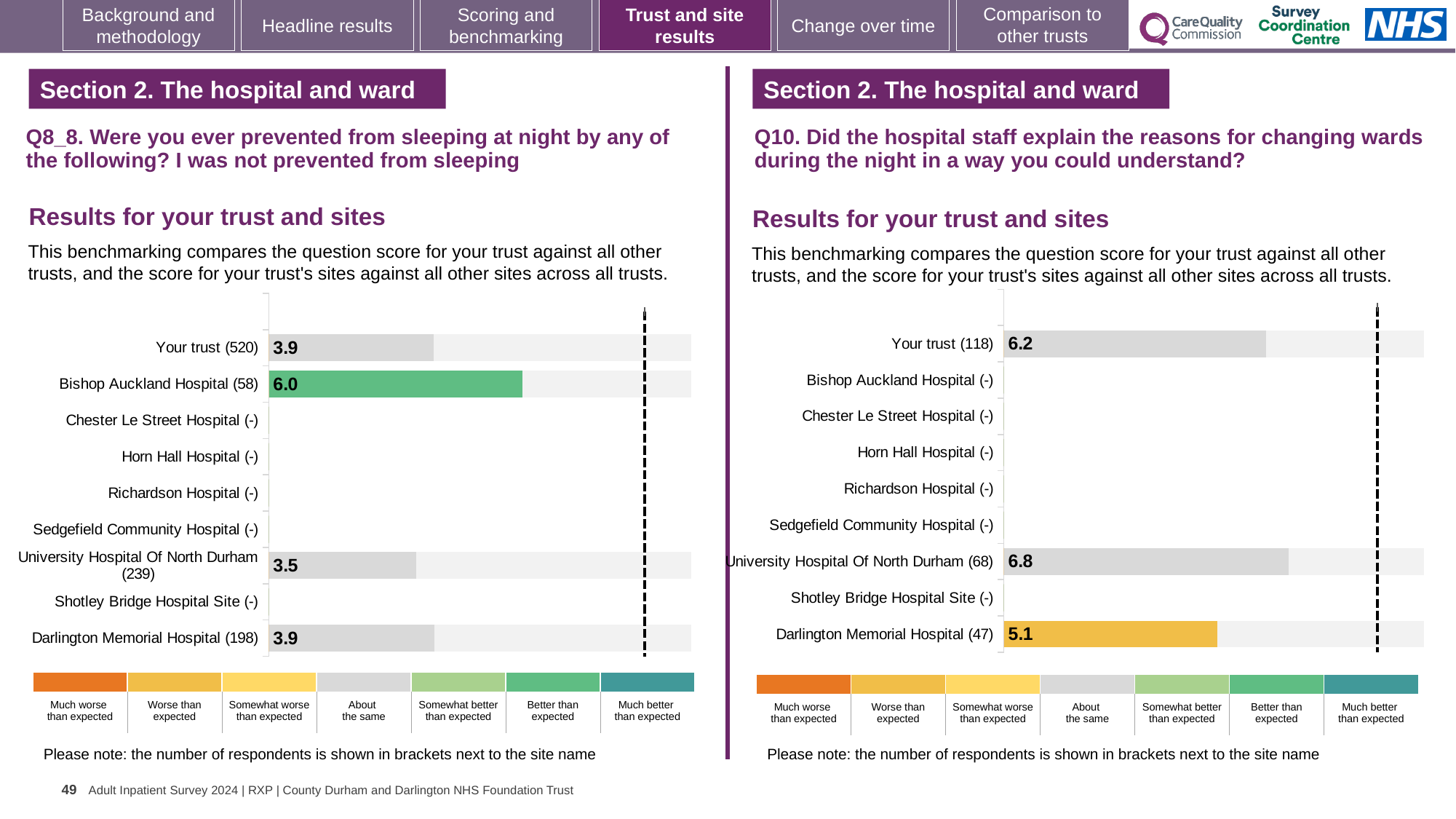
In the Q10 chart on the right, is the score for University Hospital Of North Durham larger or smaller than the score for Your trust? larger In the Q8_8 chart on the left, which site has the highest score? Bishop Auckland Hospital In the Q10 chart on the right, what is the score for Darlington Memorial Hospital? 5.1 In the Q8_8 chart on the left, what is the score for Bishop Auckland Hospital? 6.0 What kind of chart is used on the left side of the slide for Q8_8? bar chart In the Q10 chart on the right, which site has the lowest score among those with a value shown? Darlington Memorial Hospital In the Q8_8 chart on the left, what is the score for University Hospital Of North Durham? 3.5 In the Q10 chart on the right, what is the score for Your trust? 6.2 In the Q8_8 chart on the left, how many respondents are shown for Your trust? 520 In the Q10 chart on the right, how many rows (trust and sites) are listed on the vertical axis? 9 In the Q10 chart on the right, what is the difference between the scores for University Hospital Of North Durham and Darlington Memorial Hospital? 1.7 In the Q8_8 chart on the left, what is the difference between the scores for Bishop Auckland Hospital and University Hospital Of North Durham? 2.5